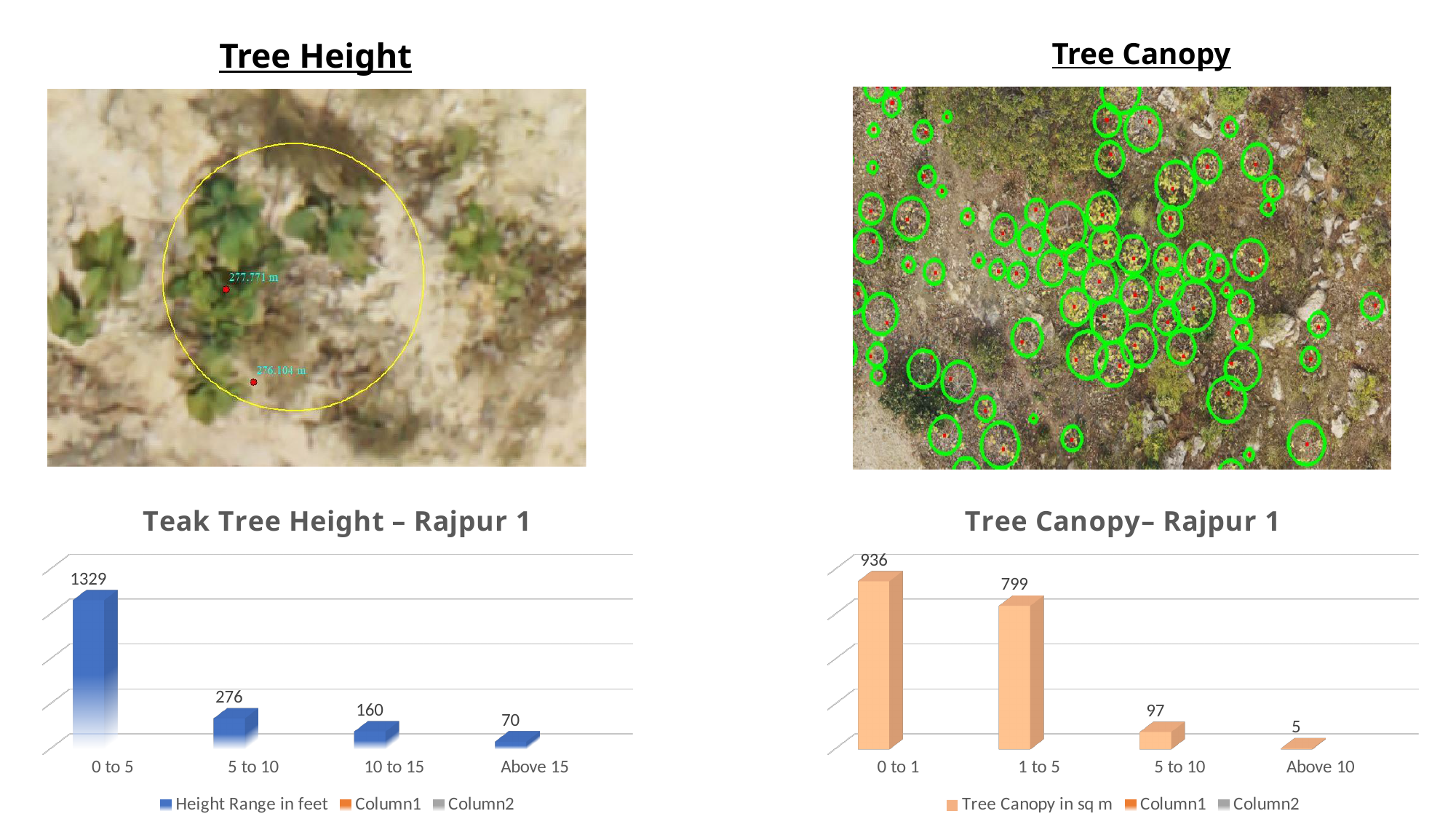
In the 'Teak Tree Height – Rajpur 1' chart, what is the value for 'Above 15'? 70 In the 'Tree Canopy– Rajpur 1' chart, what is the value for the '1 to 5' category? 799 In the 'Teak Tree Height – Rajpur 1' chart, how many categories are shown on the x axis? 4 In the 'Tree Canopy– Rajpur 1' chart, what is the difference between the '0 to 1' and '1 to 5' values? 137 In the 'Teak Tree Height – Rajpur 1' chart, what is the value for the '0 to 5' category? 1329 In the 'Teak Tree Height – Rajpur 1' chart, do the values rise or fall from left to right along the x axis? fall What kind of chart is 'Tree Canopy– Rajpur 1'? bar chart In the 'Tree Canopy– Rajpur 1' chart, which category has the highest value? 0 to 1 In the 'Tree Canopy– Rajpur 1' chart, which is larger, the value for '5 to 10' or the value for 'Above 10'? 5 to 10 How many series does the legend of the 'Teak Tree Height – Rajpur 1' chart list? 3 In the 'Teak Tree Height – Rajpur 1' chart, which category has the lowest value? Above 15 In the 'Teak Tree Height – Rajpur 1' chart, what is the difference between the '5 to 10' and '10 to 15' values? 116